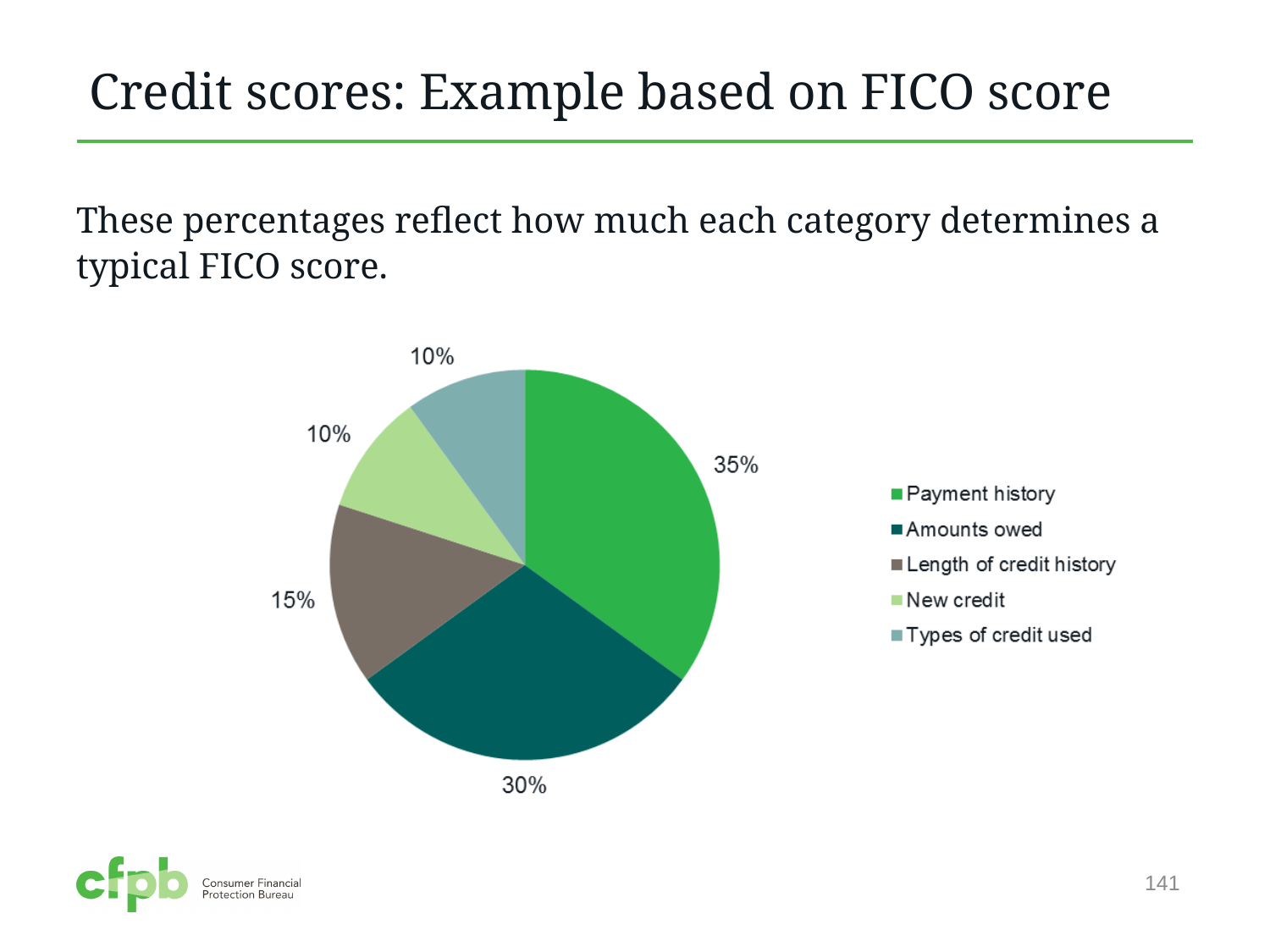
What share of the FICO score does Payment history account for? 35% What is the difference in percentage points between Payment history and Amounts owed? 5 Which is larger, the share for Length of credit history or the share for New credit? Length of credit history How many categories does the pie chart show? 5 What share of the FICO score does Amounts owed account for? 30% Which category has the largest slice of the pie? Payment history What kind of chart is shown on the slide? Pie chart What share of the FICO score does New credit account for? 10% Which category is shown in the darkest colour in the pie chart? Amounts owed What share of the FICO score does Length of credit history account for? 15% What is the difference in percentage points between Amounts owed and Length of credit history? 15 What share of the FICO score does Types of credit used account for? 10%